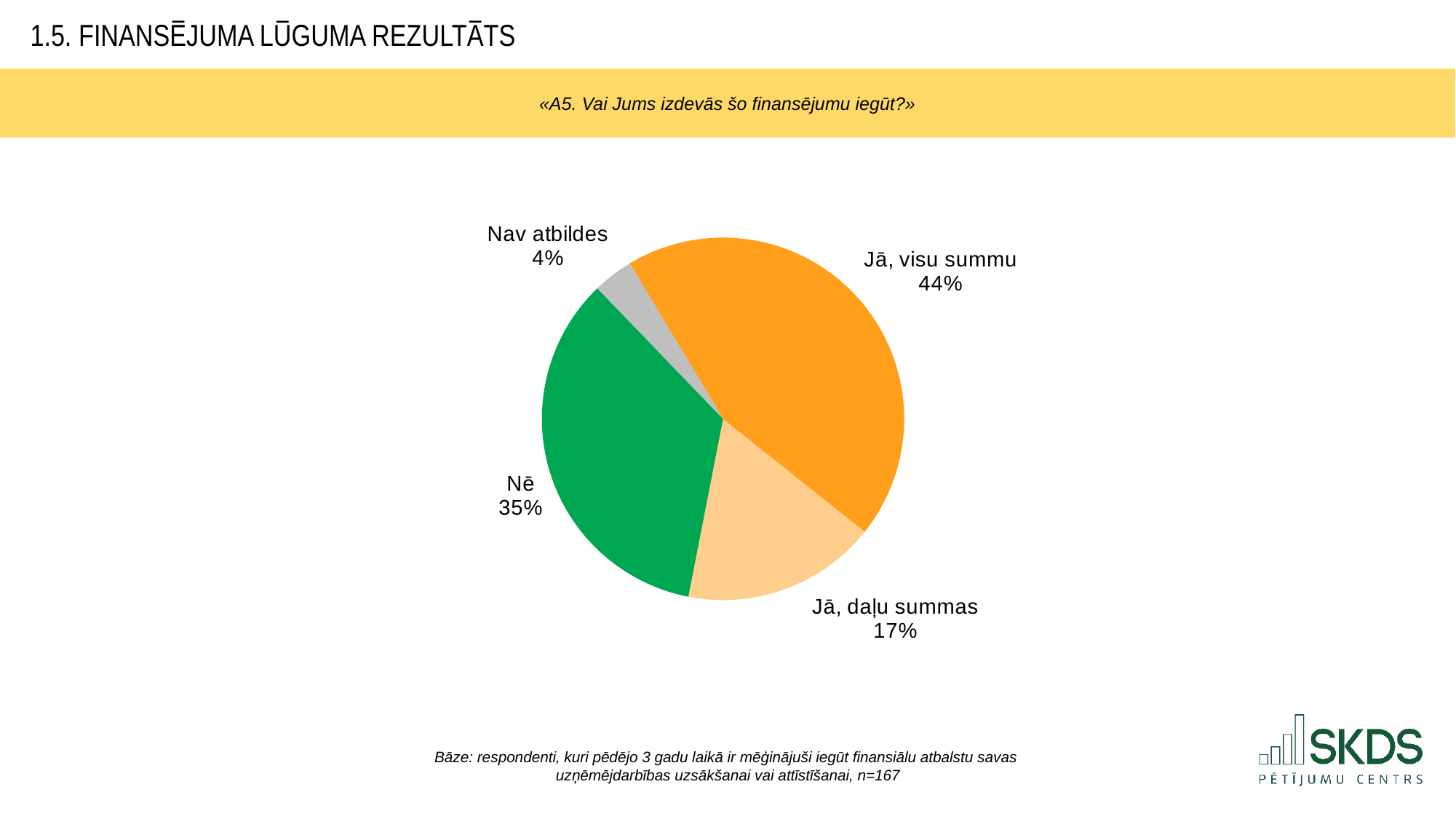
What colour is the slice for "Nē"? Green Which category has the smallest share of the pie? Nav atbildes What percentage of respondents answered "Jā, daļu summas"? 17% How many categories are shown in the pie chart? 4 What percentage of respondents answered "Jā, visu summu"? 44% What percentage of respondents gave no answer ("Nav atbildes")? 4% What percentage of respondents answered "Nē"? 35% What type of chart is shown on the slide? Pie chart Which is larger: the share for "Nē" or the share for "Jā, daļu summas"? Nē Which category has the largest share of the pie? Jā, visu summu What is the combined share of the two "Jā" categories ("Jā, visu summu" and "Jā, daļu summas")? 61% What is the difference in percentage points between "Jā, visu summu" and "Nē"? 9